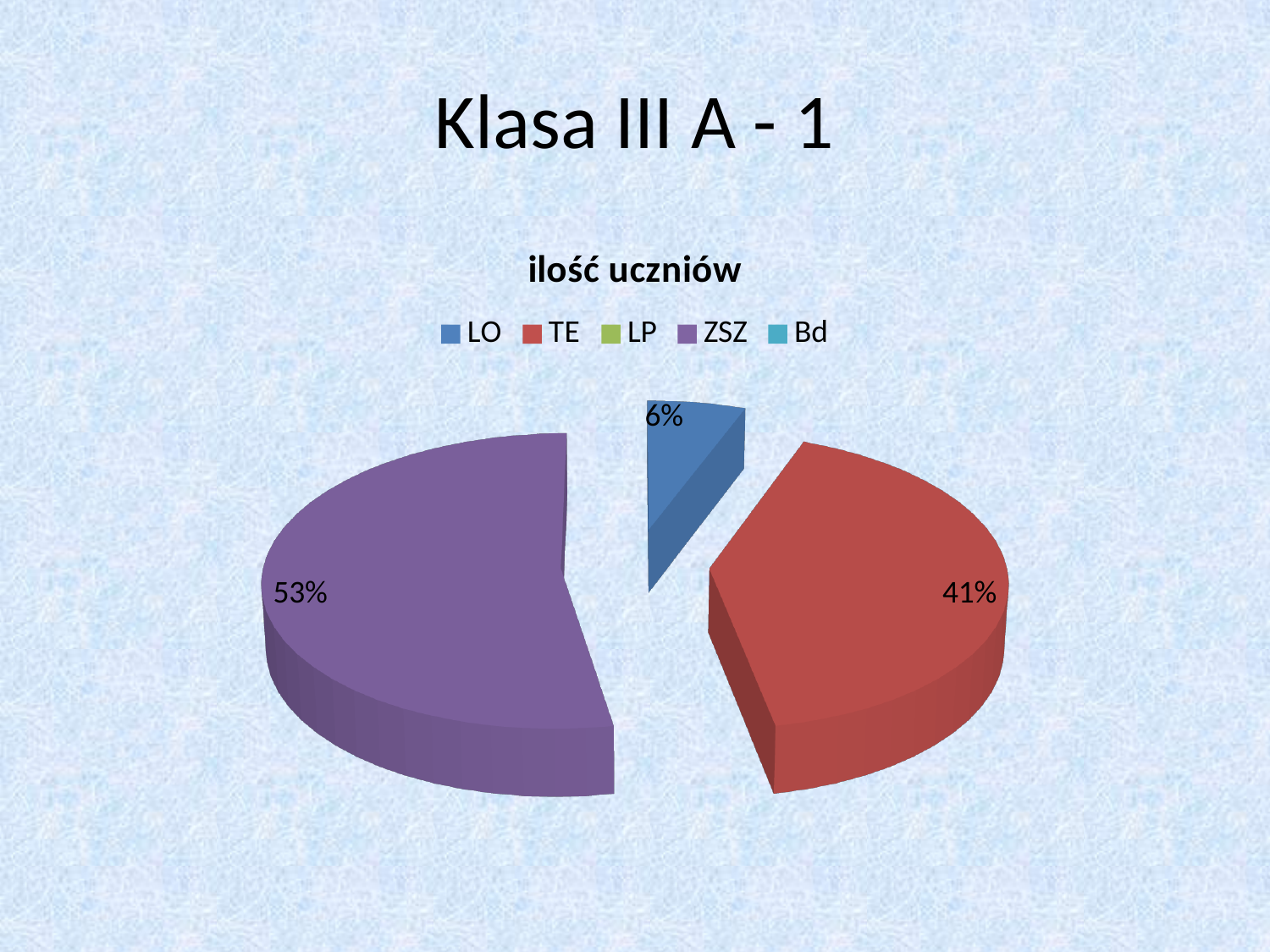
What colour is the ZSZ slice? purple What share of the pie does LO have? 6% How many entries does the chart legend list? 5 Which is larger, the TE slice or the LO slice? TE Which of the visible slices is the smallest? LO How many slices with a visible percentage label are shown in the pie? 3 What kind of chart is shown on the slide? pie chart What is the title of the chart? ilość uczniów What share of the pie does ZSZ have? 53% What is the difference in percentage points between the ZSZ and TE slices? 12 Which category has the largest slice of the pie? ZSZ What share of the pie does TE have? 41%